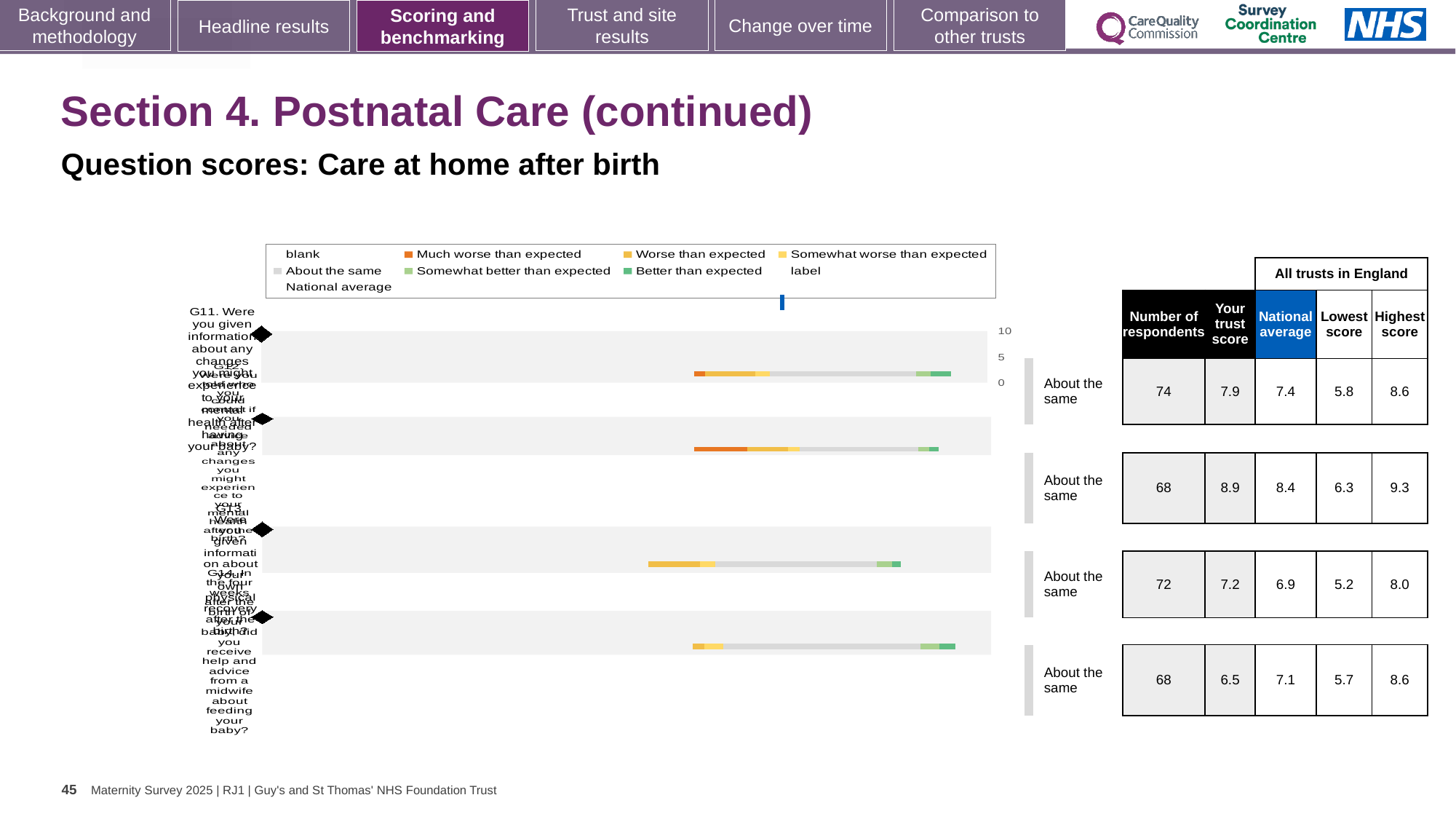
In the table, what is the 'Lowest score' for the fourth row? 5.7 Which row of the table has the highest 'Your trust score'? the second row (8.9) In the table, what is the number of respondents for the first (top) row? 74 How many question rows (bars) are plotted in the chart? 4 What is the subtitle describing the question scores shown on the slide? Question scores: Care at home after birth In the first row of the table, what is the difference between 'Your trust score' and the 'National average'? 0.5 What kind of chart is shown on the slide? bar chart In the table, what is the 'Highest score' for the third row? 8.0 What benchmark category label is shown next to each of the four bars? About the same Which row of the table has the lowest 'Your trust score'? the fourth row (6.5) In the table, what is the 'Your trust score' for the second row? 8.9 In the third row of the table, which is larger: 'Your trust score' or the 'National average'? Your trust score (7.2)